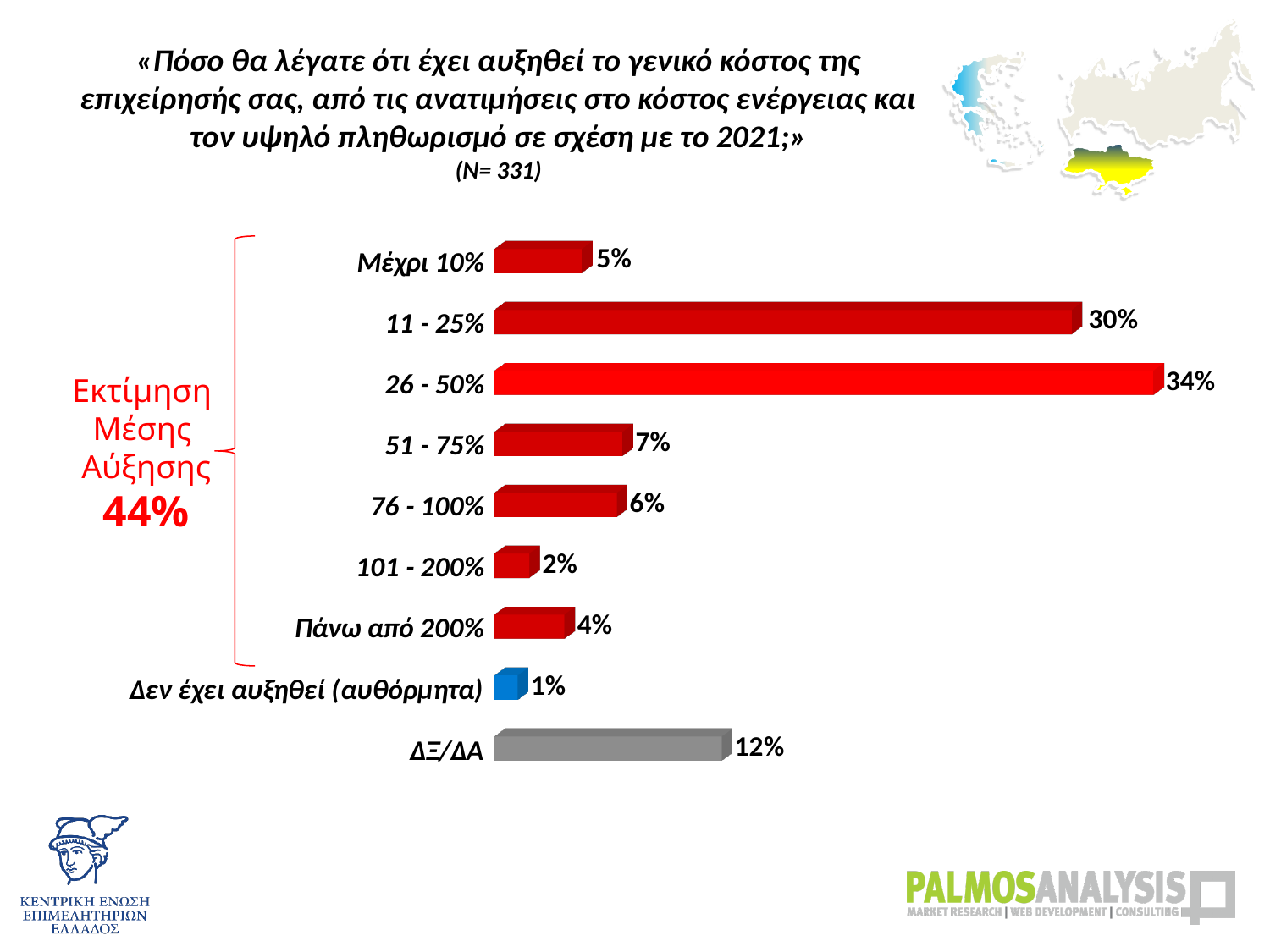
How many categories are shown in the chart? 9 What is the value for "Δεν έχει αυξηθεί (αυθόρμητα)"? 1% What is the value for "ΔΞ/ΔΑ"? 12% What is the value for the category "26 - 50%"? 34% Which category has the lowest value? Δεν έχει αυξηθεί (αυθόρμητα) What is the estimated average increase (Εκτίμηση Μέσης Αύξησης) shown next to the chart? 44% What kind of chart is shown on the slide? Bar chart What is the difference between the values for "26 - 50%" and "11 - 25%"? 4% What is the sample size (N) stated under the chart title? 331 What is the value for the category "11 - 25%"? 30% Which category has the highest value? 26 - 50% Which is larger, the value for "51 - 75%" or the value for "76 - 100%"? 51 - 75%